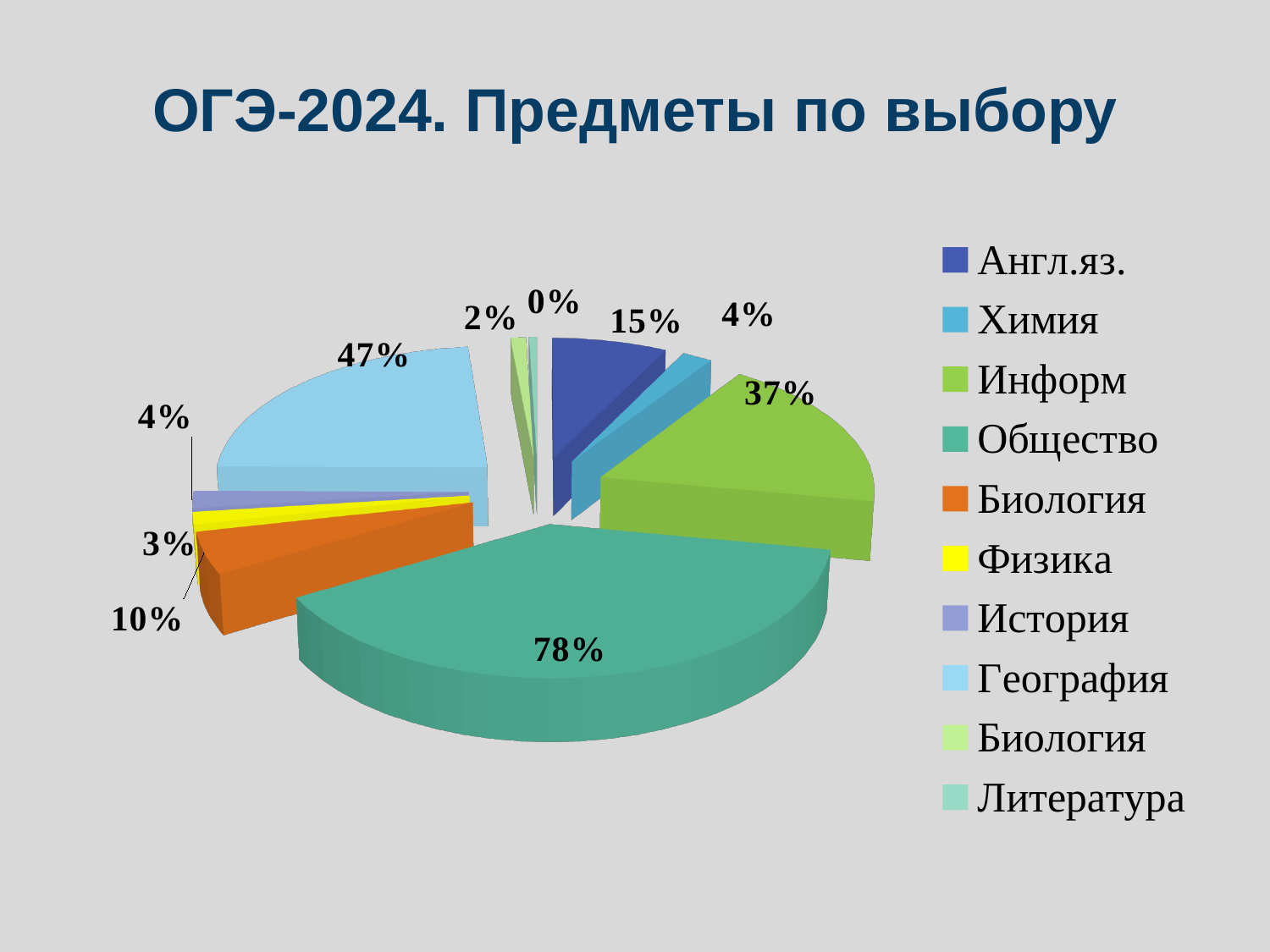
What kind of chart is shown on the slide? pie chart Which subject has the highest labelled value? Общество What is the difference between the labelled values for Общество and Информ? 41% What value is labelled for Литература? 0% What is the title of the chart on the slide? ОГЭ-2024. Предметы по выбору Which subject has the lowest labelled value? Литература How many subjects are listed in the chart's legend? 10 What value is labelled for Англ.яз.? 15% What value is labelled for География? 47% What value is labelled for Общество? 78% What value is labelled for Физика? 3% What value is labelled for Информ? 37%